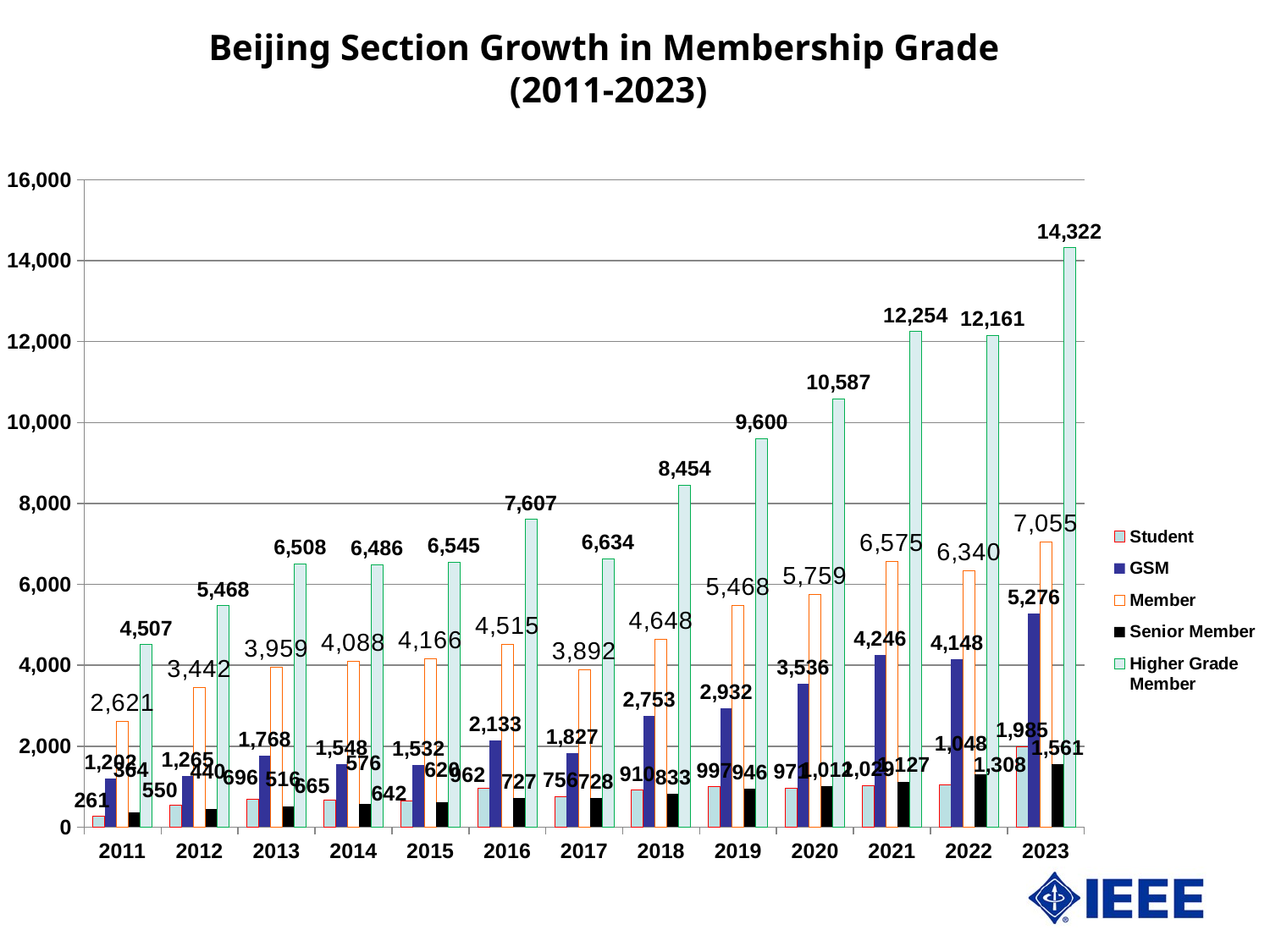
What is the GSM value for 2021? 4,246 In which year is the Higher Grade Member value lowest? 2011 What is the Higher Grade Member value for 2023? 14,322 Which is larger, the Member value for 2021 or the Member value for 2022? 2021 In which year is the Higher Grade Member value highest? 2023 What is the difference between the Higher Grade Member values for 2023 and 2022? 2,161 How many series does the legend list? 5 What is the Member value for 2019? 5,468 Is the GSM value for 2023 greater or less than 4,000? greater What type of chart is shown on the slide? Bar chart What is the title of the chart? Beijing Section Growth in Membership Grade (2011-2023) How many years are shown on the x axis? 13